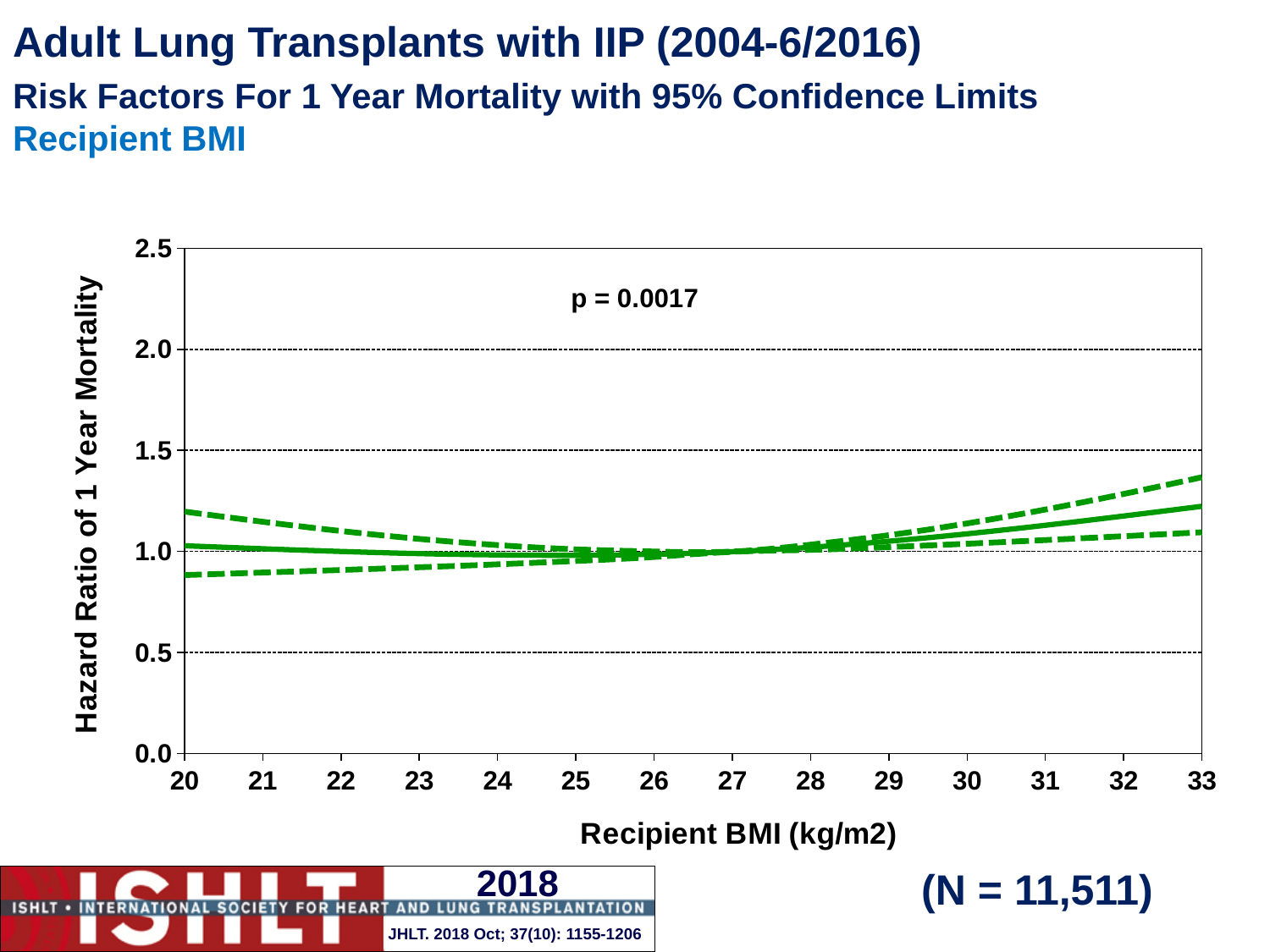
At which recipient BMI value on the x axis is the hazard ratio (solid line) highest? 33 Is the hazard ratio (solid line) at a recipient BMI of 33 greater or less than 1.0? greater What sample size (N) is shown on the slide? N = 11,511 Is the hazard ratio (solid line) larger at a recipient BMI of 33 or at a recipient BMI of 20? 33 How many recipient BMI tick values are labelled on the x axis? 14 Is the upper 95% confidence limit at a recipient BMI of 20 greater or less than 1.0? greater Does the hazard ratio (solid line) rise or fall as recipient BMI increases from 27 to 33? rise Is the upper 95% confidence limit at a recipient BMI of 33 greater or less than 1.5? less What p-value is printed on the chart? p = 0.0017 What kind of chart is shown on the slide? line chart